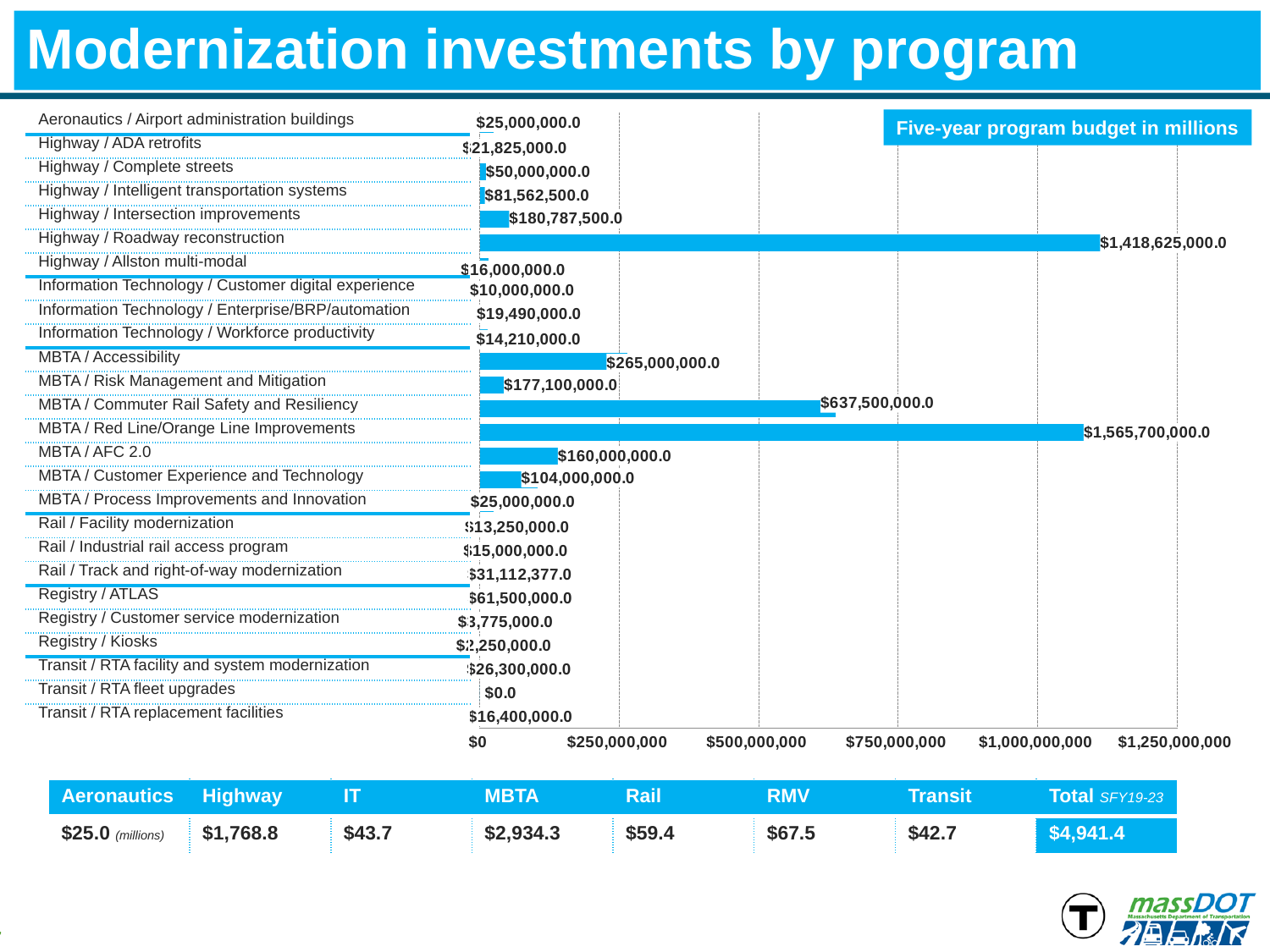
What is the value for Highway / Roadway reconstruction? $1,418,625,000.0 What is the value for Highway / Intersection improvements? $180,787,500.0 Which program has the highest value? MBTA / Red Line/Orange Line Improvements How many programs are plotted in the chart? 26 Is the value for Highway / Roadway reconstruction greater or less than $1,000,000,000? greater What kind of chart is shown on the slide? bar chart What is the difference between MBTA / Red Line/Orange Line Improvements and Highway / Roadway reconstruction? $147,075,000.0 What is the value for MBTA / AFC 2.0? $160,000,000.0 Which is larger, MBTA / Commuter Rail Safety and Resiliency or MBTA / Accessibility? MBTA / Commuter Rail Safety and Resiliency Which program has the lowest value? Transit / RTA fleet upgrades What is the value for Rail / Track and right-of-way modernization? $31,112,377.0 What colour are the bars in the chart? blue